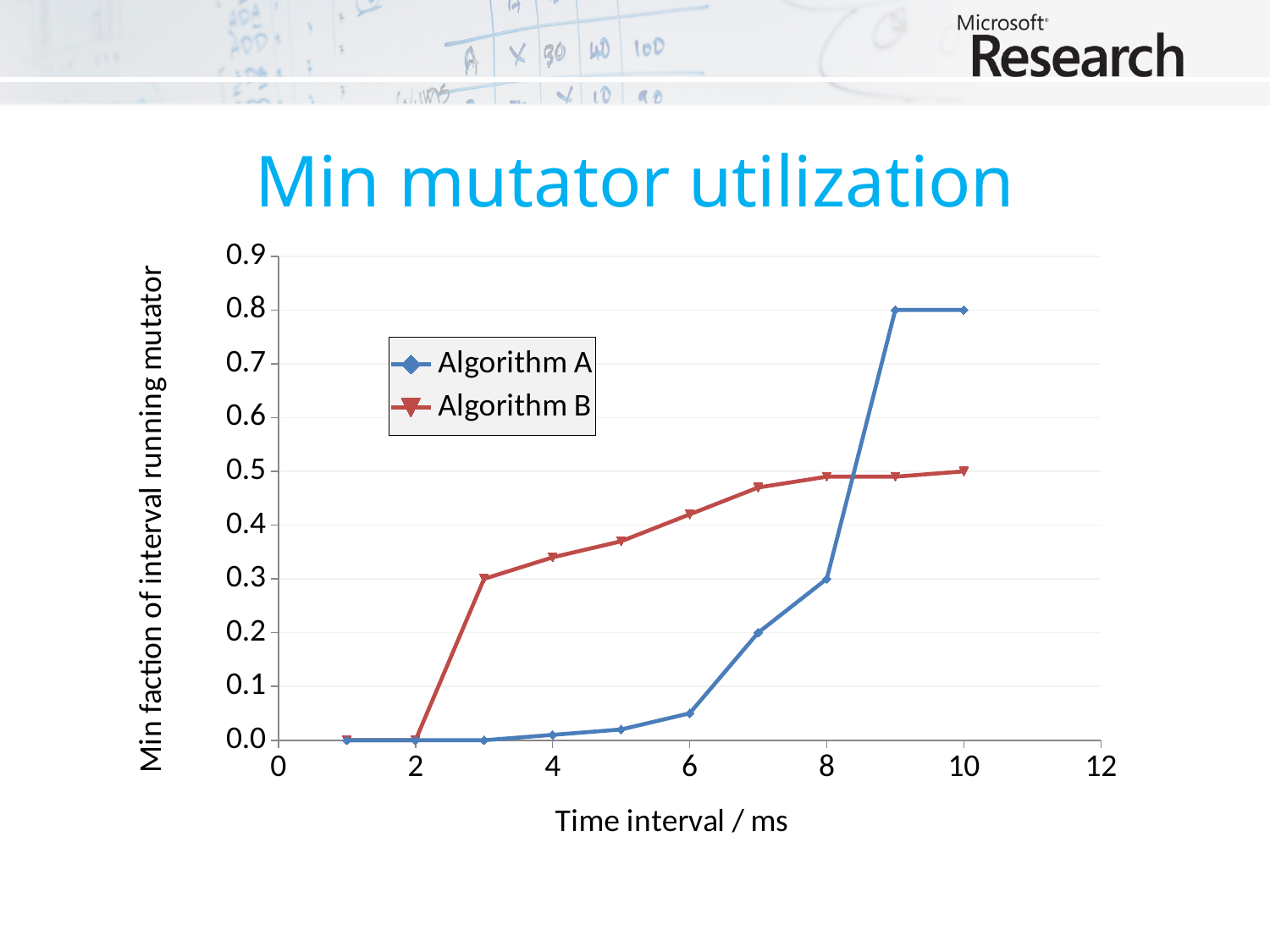
How many series does the legend list? 2 What is the title of the chart? Min mutator utilization Which series has the larger value at a time interval of 8 ms, Algorithm A or Algorithm B? Algorithm B What is the value for Algorithm A at a time interval of 8 ms? 0.3 What is the value for Algorithm A at a time interval of 10 ms? 0.8 What kind of chart is shown on the slide? Line chart Do the values for Algorithm B generally rise or fall as the time interval increases? rise How many data points are plotted for Algorithm A? 10 What is the value for Algorithm B at a time interval of 10 ms? 0.5 Is the value for Algorithm B at a time interval of 7 ms greater or less than 0.5? less Which series has the larger value at a time interval of 10 ms, Algorithm A or Algorithm B? Algorithm A What is the label of the x axis? Time interval / ms